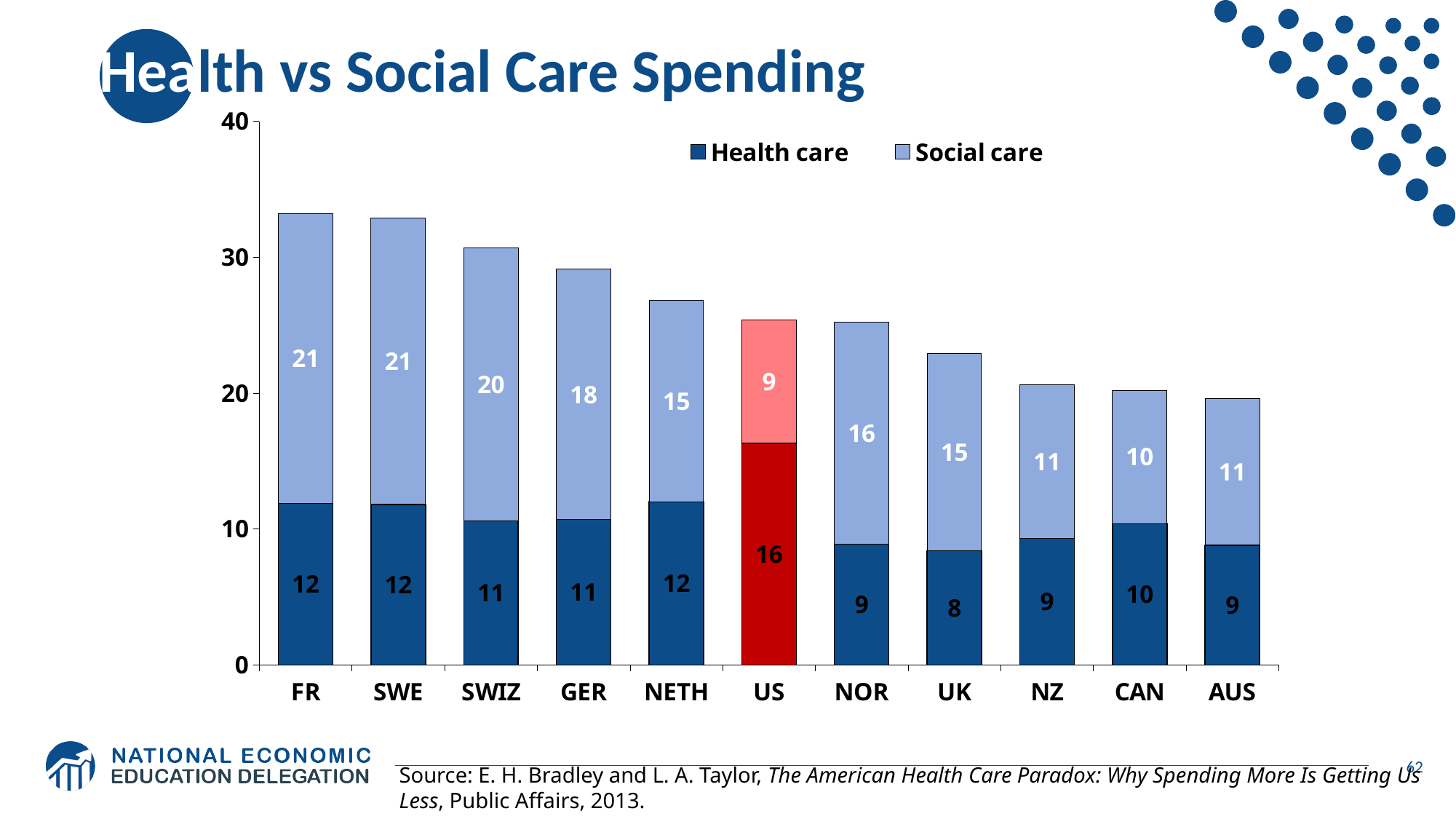
Which country has the lowest Health care value? UK What is the difference between the Health care value for the US and the Health care value for the UK? 8 Is the total height of the FR bar greater or less than 30? greater What is the total of the US bar (Health care plus Social care)? 25 How many series does the legend list? 2 What kind of chart is shown on the slide? Stacked bar chart What is the Health care value for the US? 16 Which country has the highest Health care value? US Which is larger, the Social care value for FR or the Social care value for the US? FR How many countries are shown on the x axis? 11 Which country has the lowest Social care value? US What is the Social care value for Germany (GER)? 18